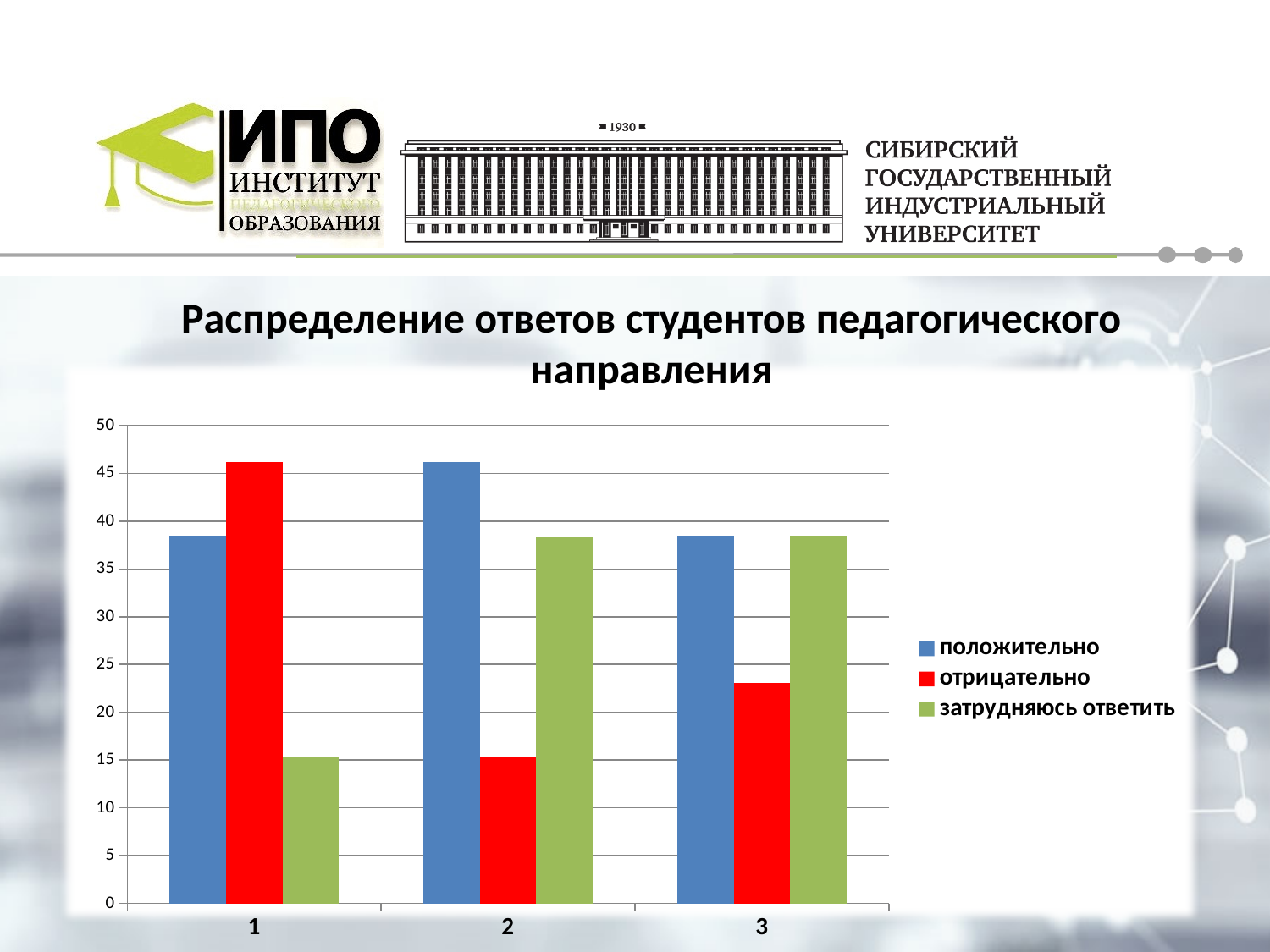
Is the value for "отрицательно" in category 1 greater or less than 40? greater In category 3, which is larger: "положительно" or "отрицательно"? положительно In category 2, which series has the lowest value? отрицательно How many series does the legend list? 3 In category 1, which series has the highest value? отрицательно How many categories are shown on the x axis? 3 Which colour represents the series "отрицательно" in the legend? red Is the value for "положительно" in category 2 greater or less than 40? greater What kind of chart is shown on the slide? bar chart Is the value for "отрицательно" in category 3 greater or less than 30? less What is the title of the chart? Распределение ответов студентов педагогического направления